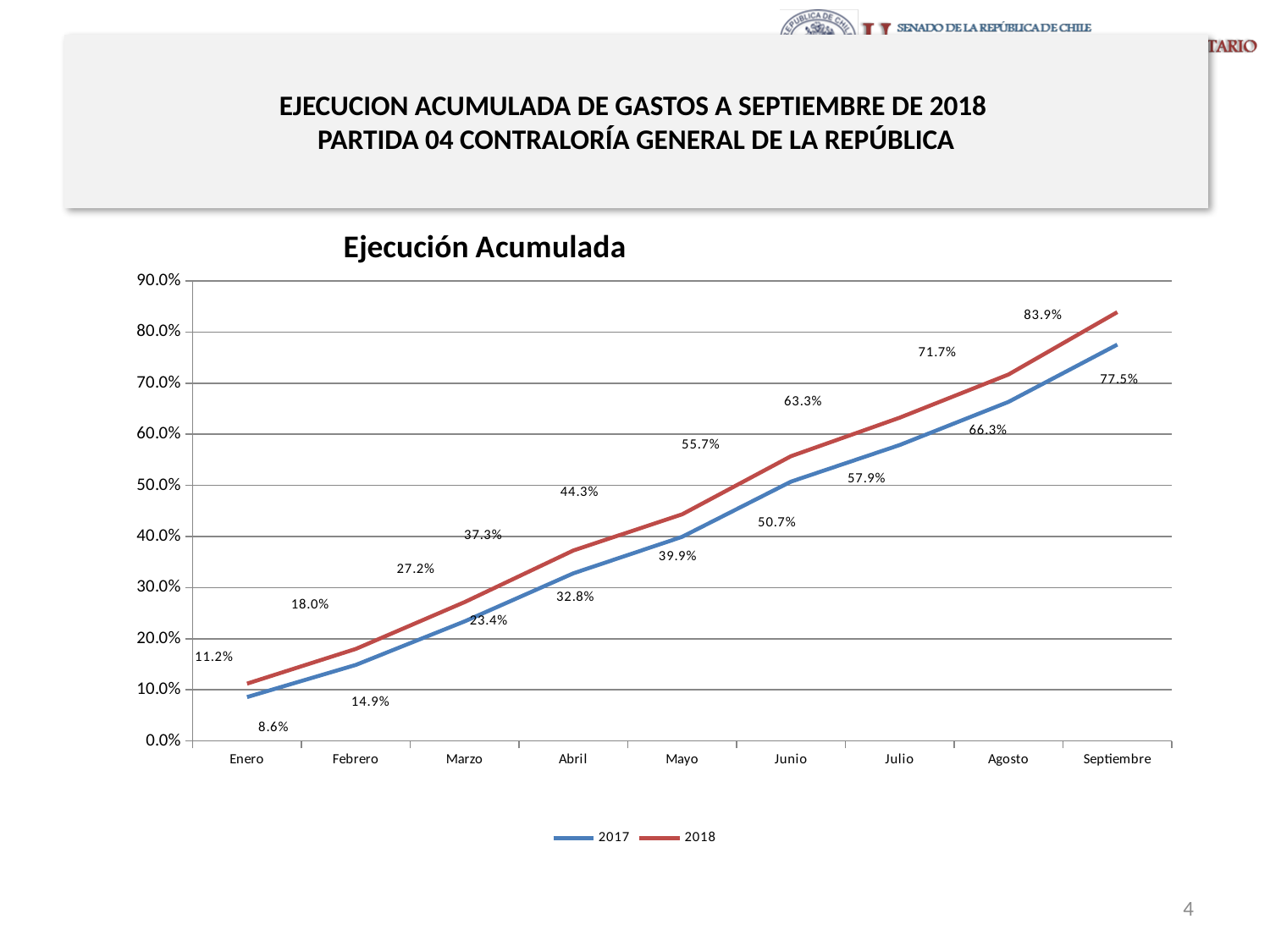
Which series has the higher value in Junio, 2017 or 2018? 2018 What is the difference between the 2018 and 2017 values in Septiembre? 6.4% What is the value for 2018 in Septiembre? 83.9% What is the value for 2017 in Julio? 57.9% What is the value for 2018 in Mayo? 44.3% What is the value for 2017 in Enero? 8.6% What kind of chart is shown on the slide? Line chart In which month is the 2017 series lowest? Enero Do the values of the 2017 series rise or fall from Enero to Septiembre? Rise How many series does the legend list? 2 How many months are plotted along the x axis? 9 In which month is the 2018 series highest? Septiembre